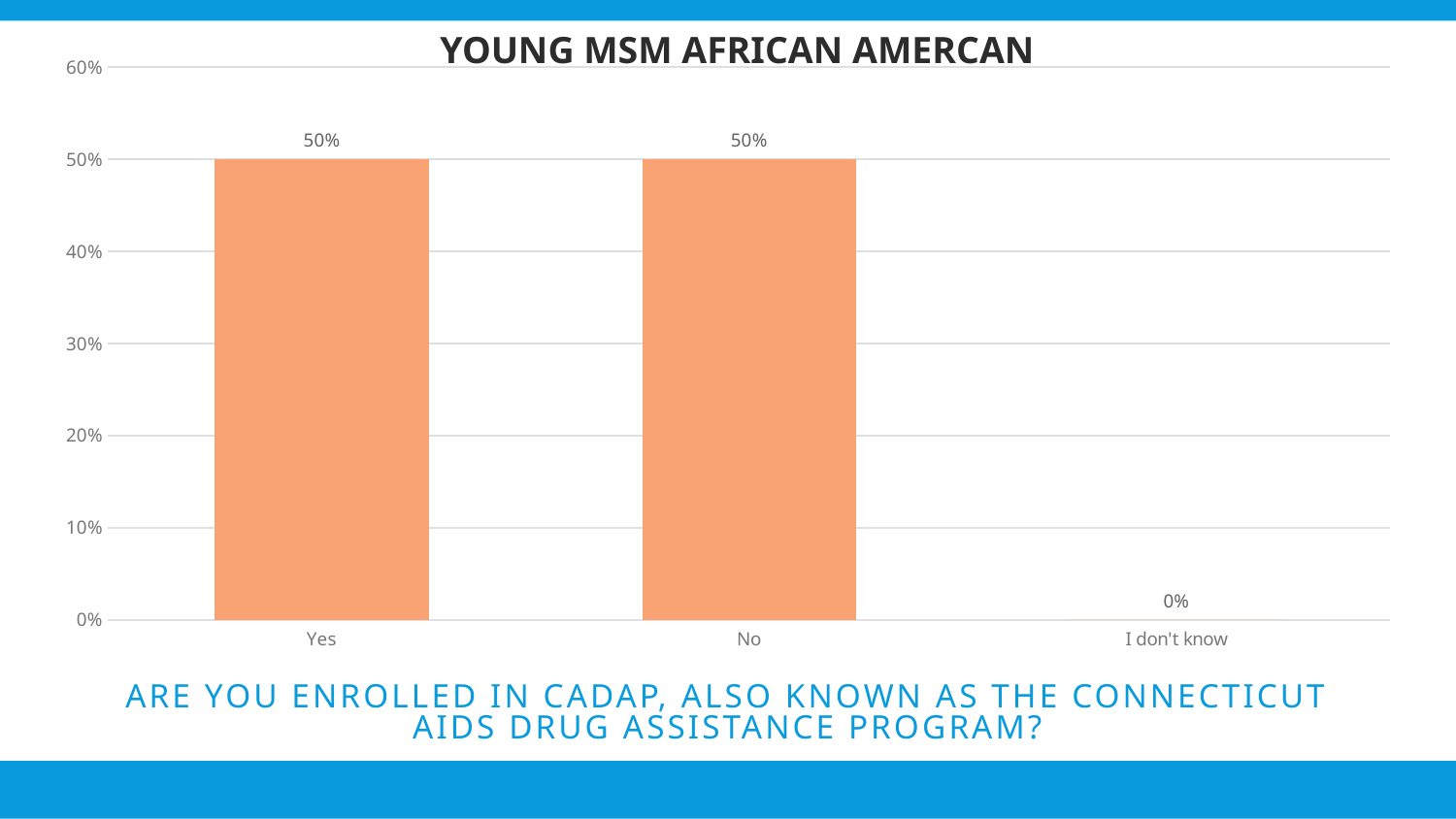
What is the value for No? 50% What kind of chart is shown on the slide? bar chart What is the difference between the values for Yes and I don't know? 50% What is the value for I don't know? 0% Is the value for Yes greater or less than 40%? greater Which category has the lowest value? I don't know What is the value for Yes? 50% Which is larger, the value for No or the value for I don't know? No How many categories are shown on the x axis? 3 Is the value for I don't know greater or less than 10%? less What is the highest value shown on the y axis? 60% What is the title of the chart? YOUNG MSM AFRICAN AMERCAN